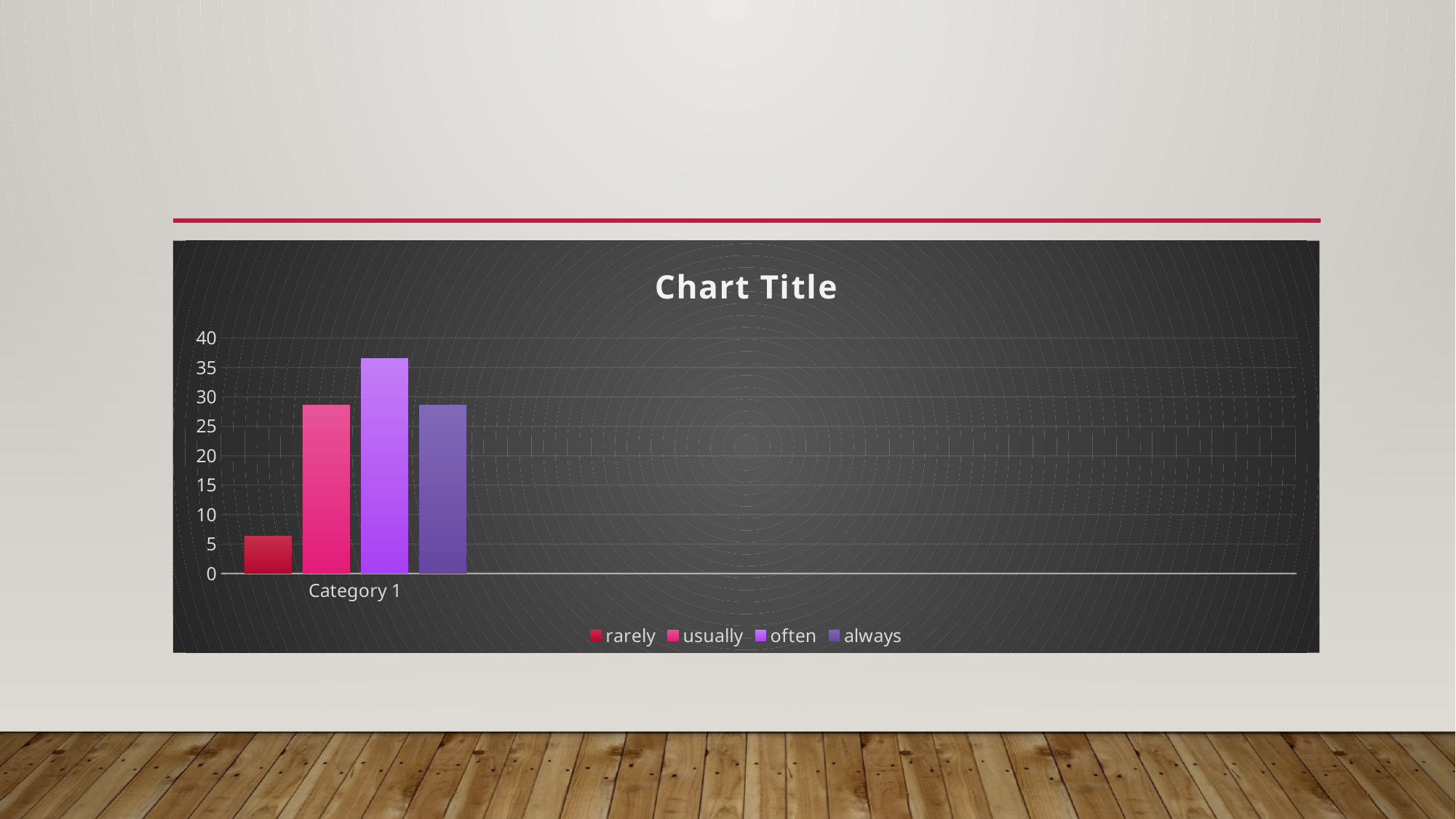
What is the label of the category on the x axis? Category 1 Which series has the lowest value for Category 1? rarely What is the title of the chart? Chart Title How many series does the legend list? 4 Is the value for 'usually' greater or less than 30? less Which series has the highest value for Category 1? often Which is larger, the value for 'often' or the value for 'rarely'? often Is the value for 'always' greater or less than 25? greater Is the value for 'rarely' greater or less than 10? less What kind of chart is shown on the slide? bar chart How many categories are shown on the x axis? 1